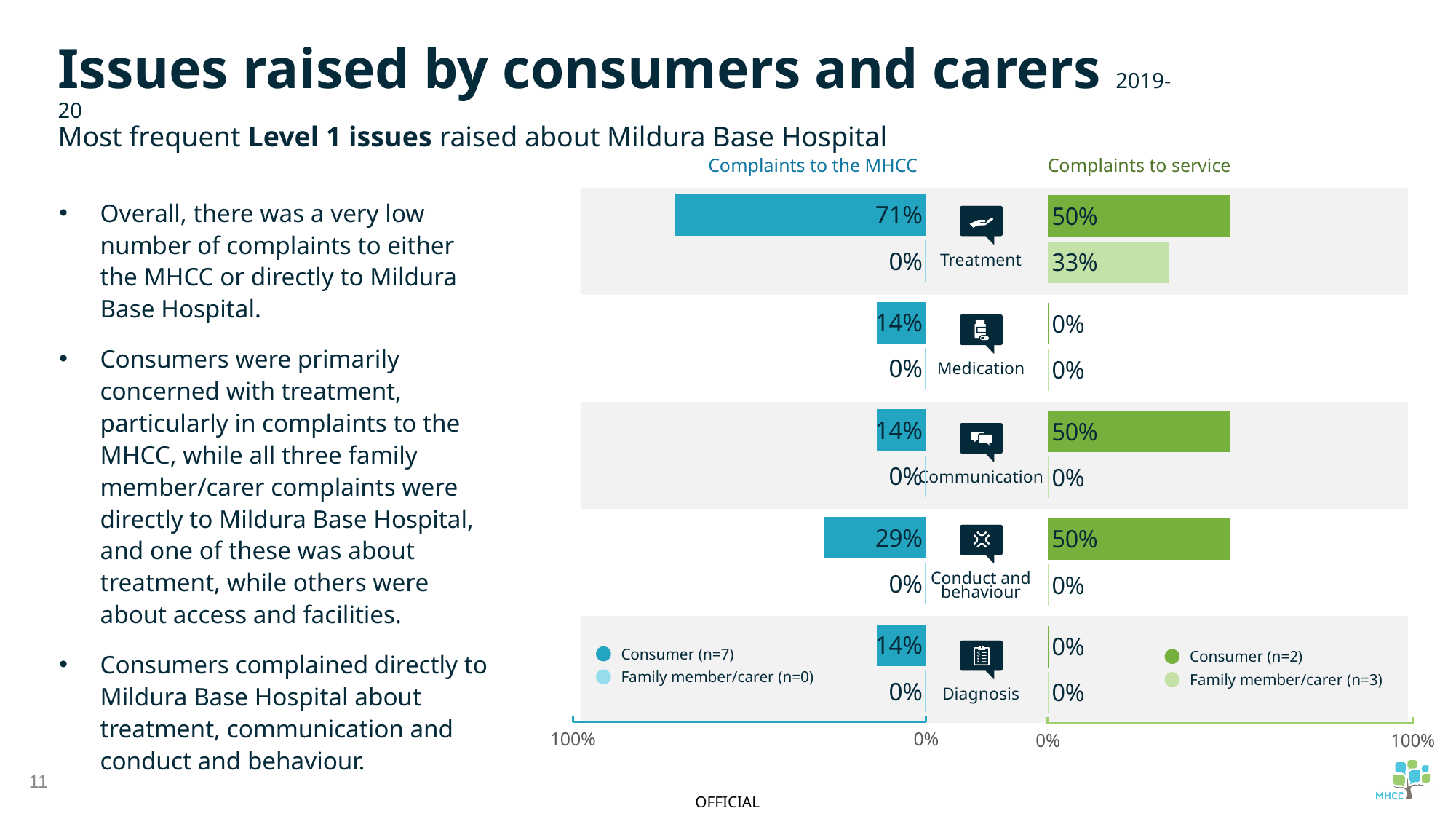
What kind of chart is the 'Complaints to the MHCC' chart? Bar chart How many categories are shown in the 'Complaints to the MHCC' chart? 5 In the 'Complaints to the MHCC' chart, what is the difference between the Consumer values for Treatment and Conduct and behaviour? 42% In the 'Complaints to the MHCC' chart, what is the Consumer value for Treatment? 71% In the 'Complaints to service' chart, which category has the highest Family member/carer value? Treatment In the 'Complaints to the MHCC' chart, which category has the highest Consumer value? Treatment In the 'Complaints to service' chart, what is the sample size (n) for the Family member/carer series shown in the legend? n=3 How many series does the legend of the 'Complaints to service' chart list? 2 In the 'Complaints to the MHCC' chart, what is the Consumer value for Conduct and behaviour? 29% In the 'Complaints to service' chart, what is the Family member/carer value for Treatment? 33% In the 'Complaints to service' chart, what is the difference between the Consumer and Family member/carer values for Treatment? 17% Which is larger: the Consumer value for Treatment in the 'Complaints to the MHCC' chart or the Consumer value for Treatment in the 'Complaints to service' chart? Complaints to the MHCC